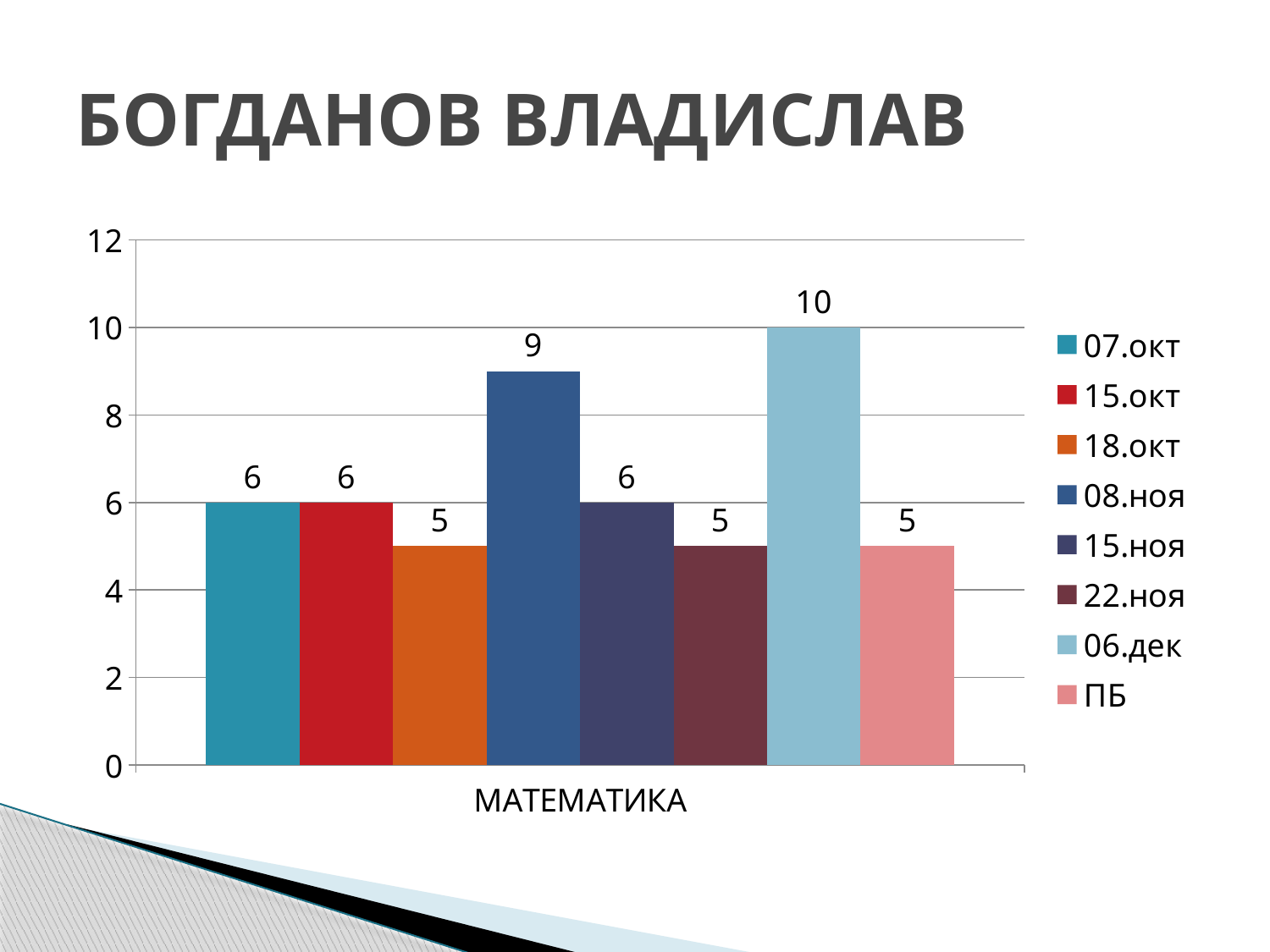
What is the difference between the values for 06.дек and 08.ноя? 1 What is the value for 08.ноя in the МАТЕМАТИКА chart? 9 How many series does the legend list? 8 Which series has the highest value? 06.дек What is the value for 18.окт? 5 Which is larger, the value for 07.окт or the value for 18.окт? 07.окт Is the value for 08.ноя greater or less than 8? greater What is the category label shown on the x axis? МАТЕМАТИКА What is the value for ПБ? 5 What kind of chart is shown on the slide? bar chart What is the value for 06.дек? 10 What is the difference between the values for 08.ноя and 15.ноя? 3